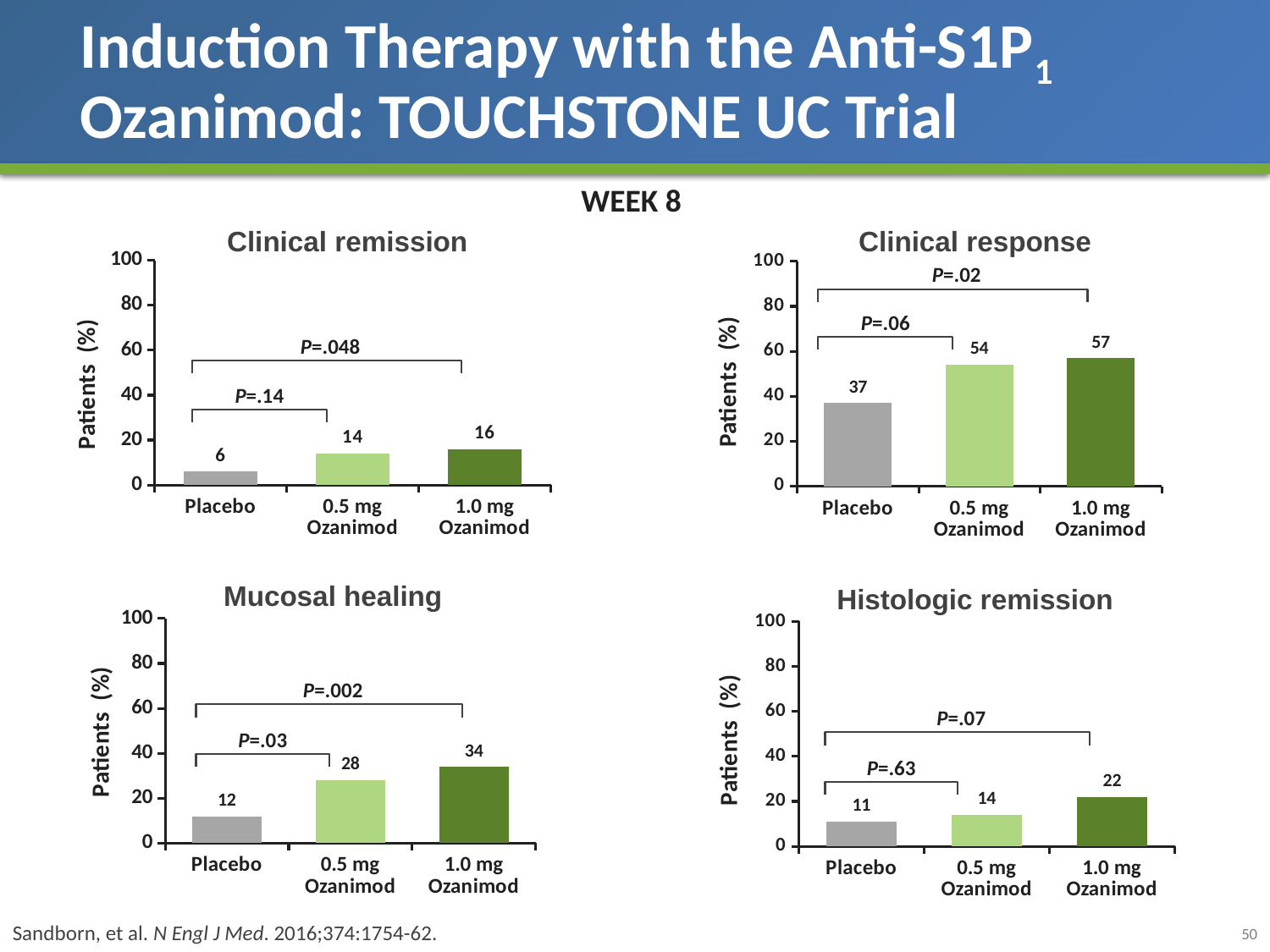
In the Mucosal healing chart, what is the value for 0.5 mg Ozanimod? 28 In the Clinical response chart, what is the value for 1.0 mg Ozanimod? 57 How many groups are shown in the Histologic remission chart? 3 In the Clinical remission chart, what is the value for Placebo? 6 In the Clinical response chart, which group has the lowest value? Placebo In the Clinical response chart, do the values rise or fall from Placebo to 1.0 mg Ozanimod? rise What is the y-axis label on the Clinical remission chart? Patients (%) What kind of chart is the Mucosal healing chart? bar chart In the Clinical remission chart, which is larger: the value for 0.5 mg Ozanimod or the value for Placebo? 0.5 mg Ozanimod In the Histologic remission chart, which group has the highest value? 1.0 mg Ozanimod In the Clinical response chart, is the value for Placebo greater or less than 20? greater In the Mucosal healing chart, what is the difference between the 1.0 mg Ozanimod and Placebo values? 22